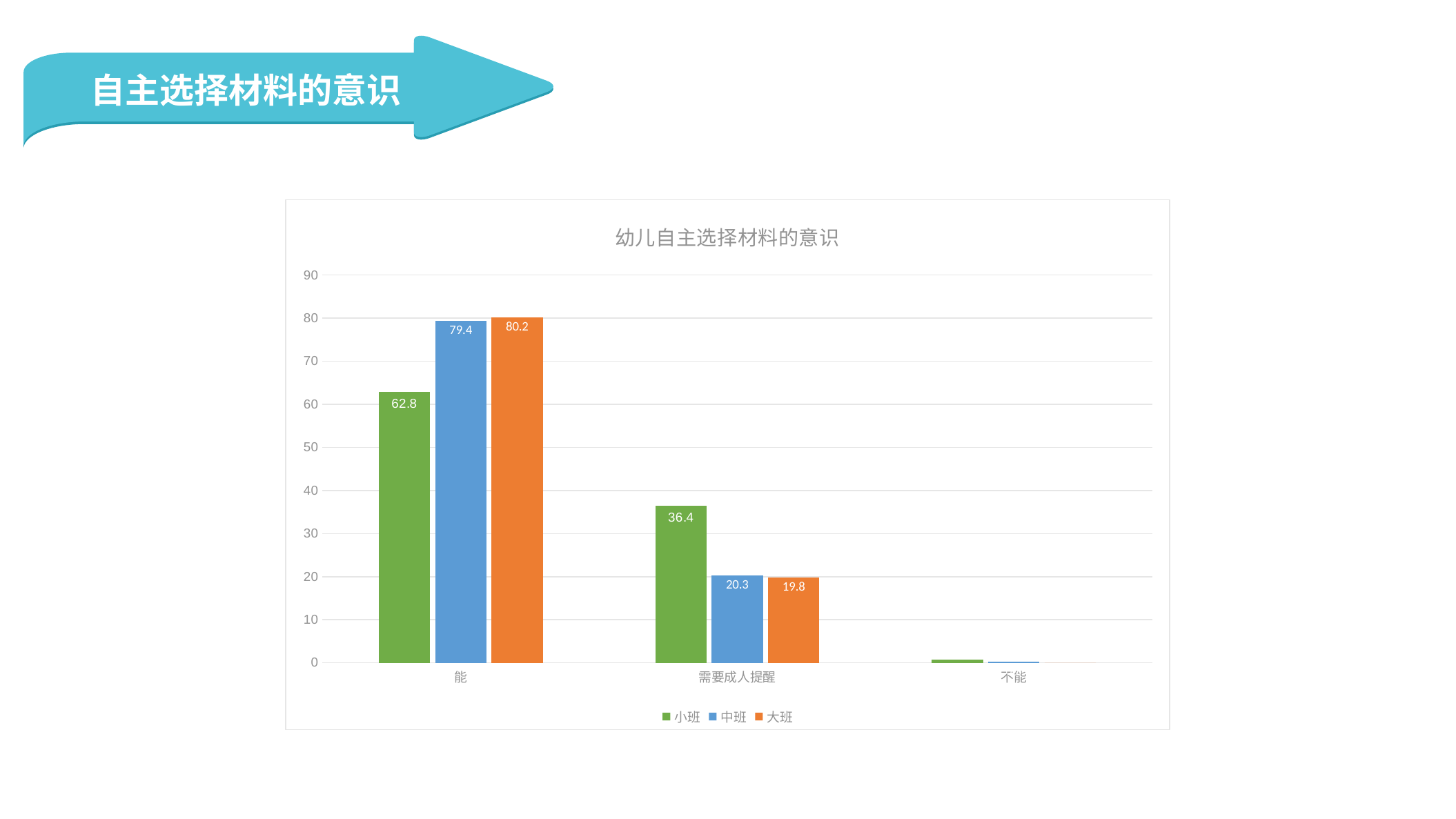
Is the value for 小班 in the 不能 category greater or less than 10? less What is the title of the chart? 幼儿自主选择材料的意识 What is the value for 中班 in the 需要成人提醒 category? 20.3 Which series has the lowest value in the 需要成人提醒 category? 大班 Which series has the highest value in the 能 category? 大班 Which is larger in the 需要成人提醒 category, 小班 or 中班? 小班 What kind of chart is shown on the slide? bar chart How many categories are shown on the x axis? 3 What is the value for 小班 in the 能 category? 62.8 How many series does the legend list? 3 What is the difference between the 中班 and 小班 values in the 能 category? 16.6 What is the value for 大班 in the 能 category? 80.2